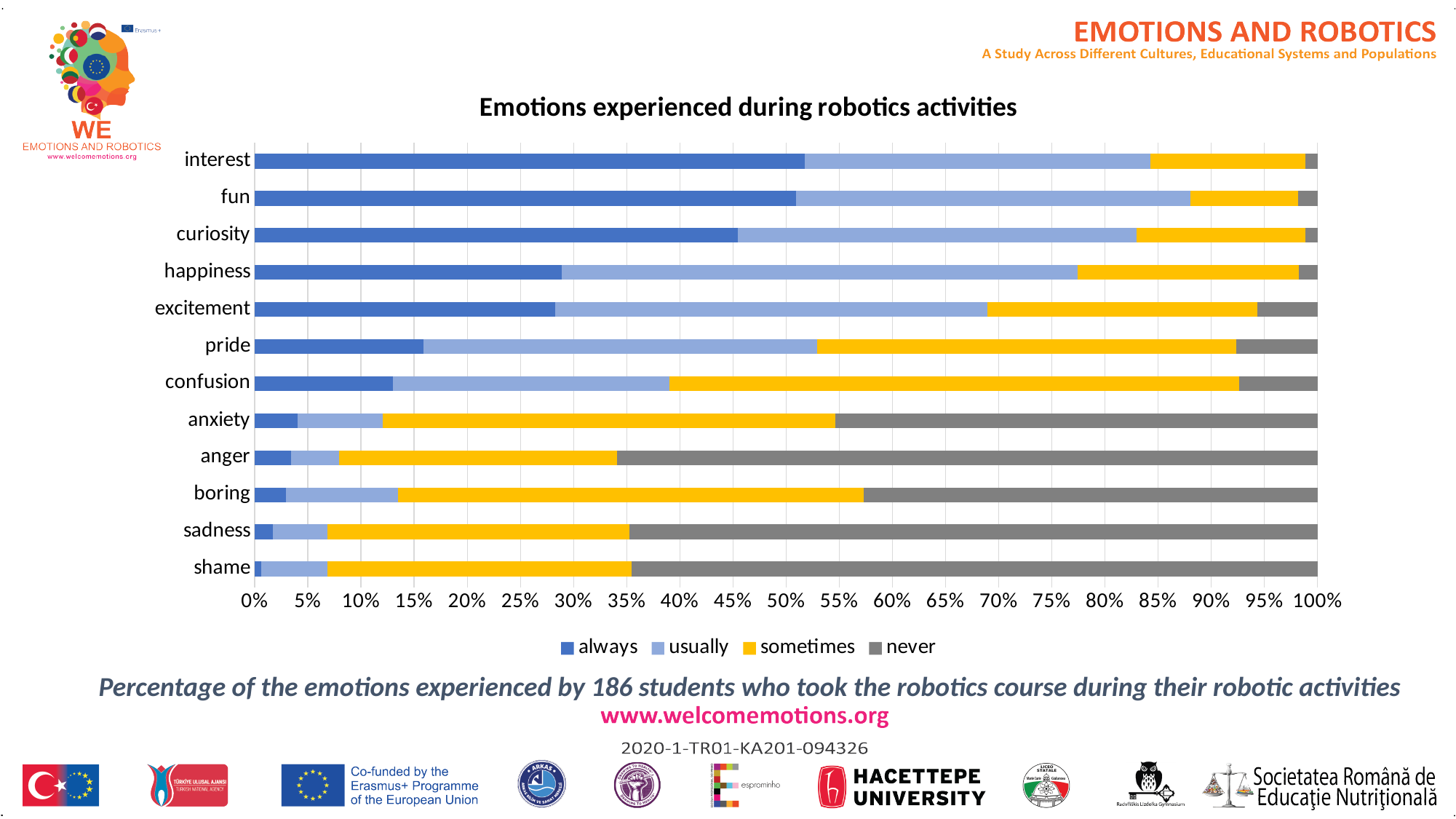
How many series does the legend list? 4 Which colour represents the 'sometimes' series in the legend? yellow What kind of chart is shown on the slide? stacked bar chart Which emotion has the smallest 'always' share? shame What is the title of the chart? Emotions experienced during robotics activities Which has the larger 'never' share, anger or confusion? anger How many emotions are listed on the vertical axis of the chart? 12 Is the 'never' share for anxiety greater or less than 40%? greater Is the 'always' share for interest greater or less than 50%? greater Which has the larger 'always' share, curiosity or happiness? curiosity Is the 'always' share for happiness greater or less than 35%? less